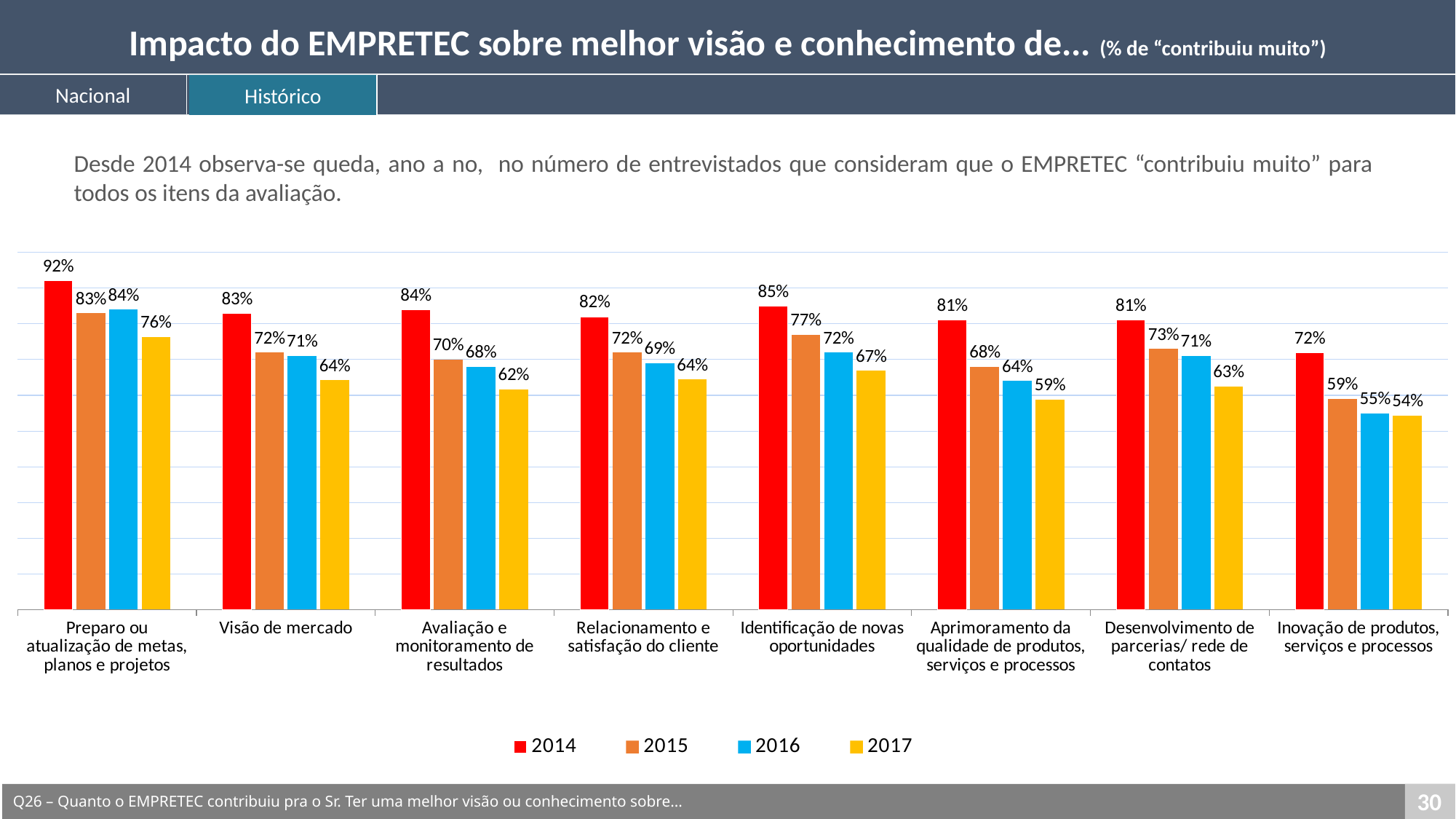
What is the 2014 value for "Preparo ou atualização de metas, planos e projetos"? 92% What kind of chart is shown on the slide? Bar chart Which category has the lowest 2017 value? Inovação de produtos, serviços e processos Which is larger for "Preparo ou atualização de metas, planos e projetos": the 2015 value or the 2016 value? 2016 What is the 2015 value for "Identificação de novas oportunidades"? 77% For "Desenvolvimento de parcerias/ rede de contatos", do the values rise or fall from 2014 to 2017? Fall How many categories are shown on the x axis? 8 Which category has the highest 2014 value? Preparo ou atualização de metas, planos e projetos What is the 2017 value for "Inovação de produtos, serviços e processos"? 54% Which colour represents the 2017 series in the legend? Yellow What is the difference between the 2014 and 2017 values for "Visão de mercado"? 19 percentage points How many series does the legend list? 4